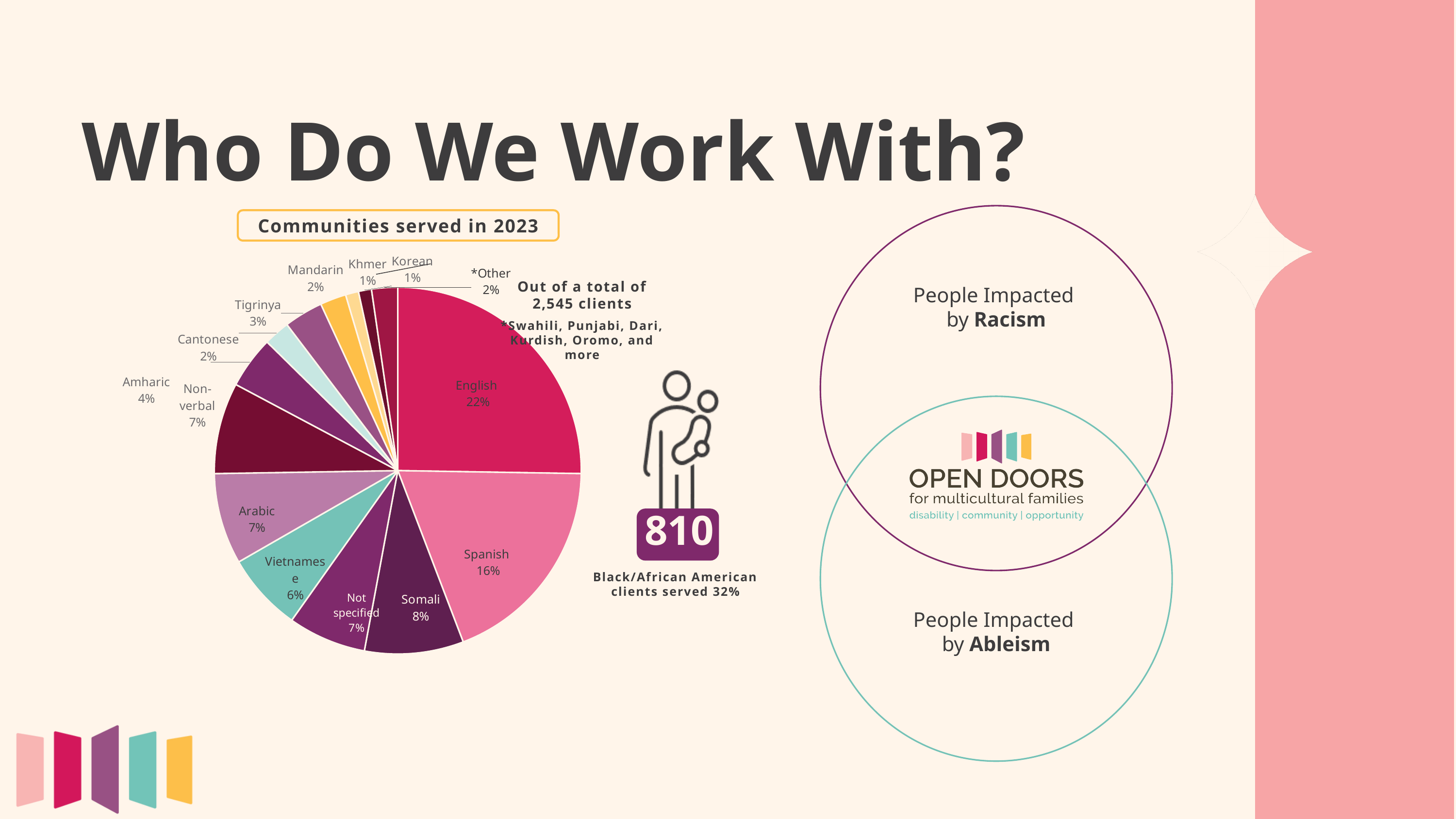
According to the text next to the pie chart, what is the total number of clients? 2,545 What percentage of the pie chart does Somali represent? 8% What percentage of the pie chart does Spanish represent? 16% What is the difference in percentage points between the English and Spanish slices? 6 What percentage of the pie chart does Amharic represent? 4% What percentage of the pie chart does English represent? 22% Which community has the largest slice of the pie chart? English Which slice is larger, Arabic or Vietnamese? Arabic What is the title of the chart on the slide? Communities served in 2023 Which slice is larger, Tigrinya or Cantonese? Tigrinya What type of chart is used to show the communities served in 2023? pie chart What share of the pie does the Non-verbal slice represent? 7%